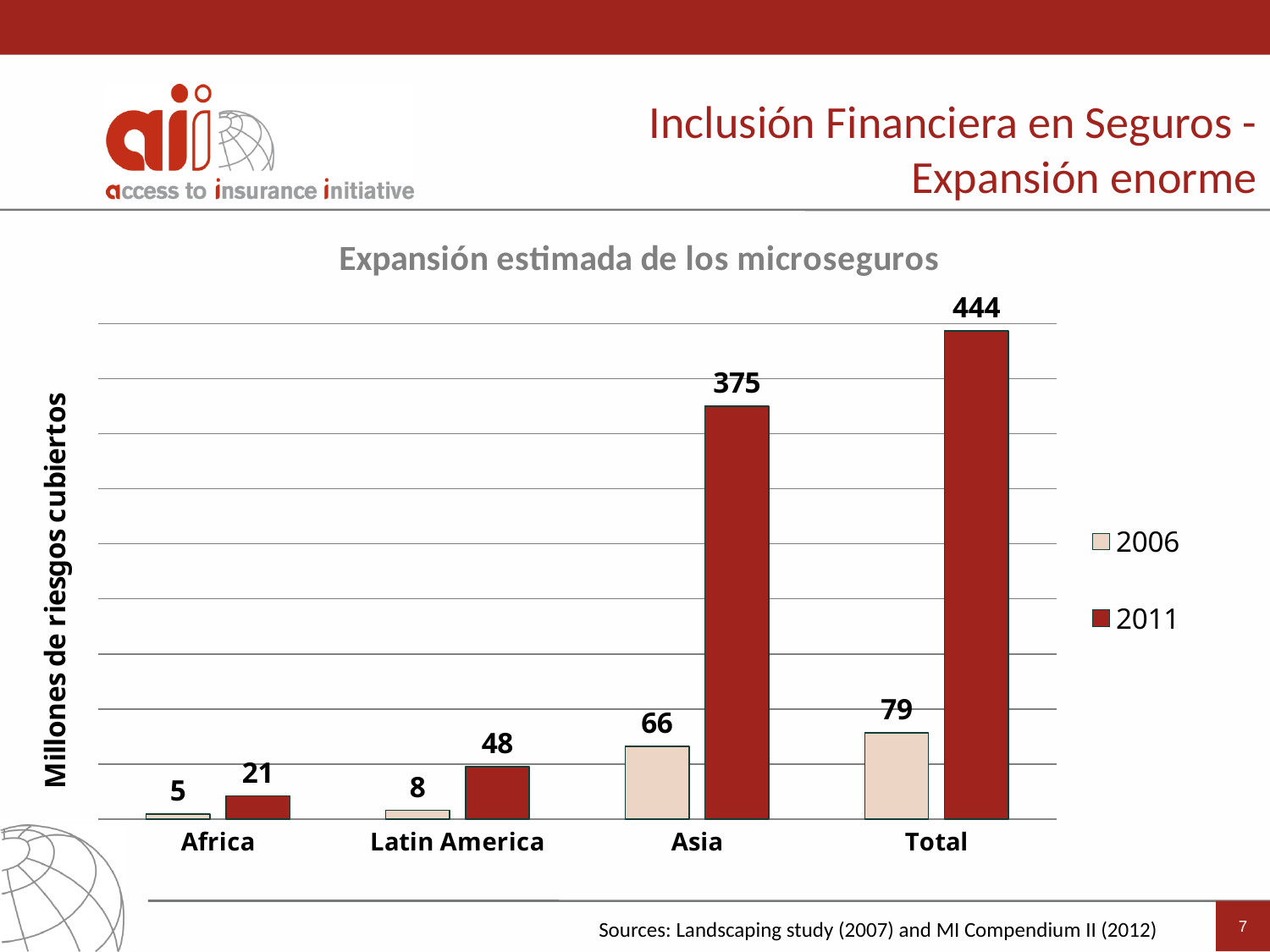
What kind of chart is shown on the slide? Bar chart What is the value for Asia in 2011? 375 Which is larger: the 2011 value for Latin America or the 2006 value for Asia? 2006 value for Asia Excluding Total, which region has the highest value in 2011? Asia What is the value for Latin America in 2011? 48 What is the value for Africa in 2006? 5 Which region has the lowest value in 2006? Africa What is the title of the chart? Expansión estimada de los microseguros What is the difference between the 2011 and 2006 values for Asia? 309 What is the Total value for 2006? 79 How many series does the legend list? 2 How many categories are shown on the x axis? 4